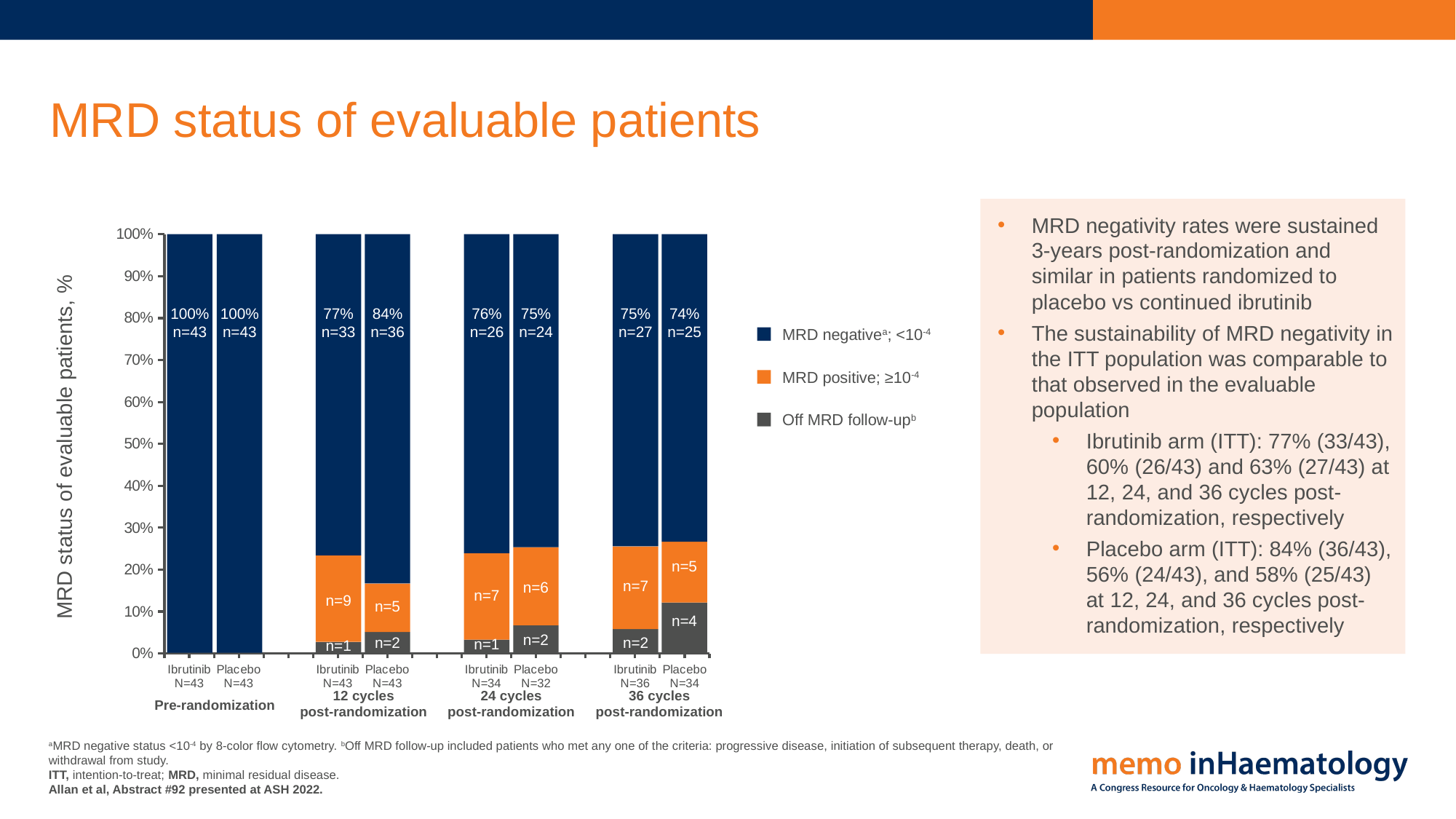
How many bars are plotted in the chart? 8 Which bar has the lowest MRD negative percentage? Placebo at 36 cycles post-randomization (74%) Does the MRD negative percentage for the Ibrutinib arm rise or fall from pre-randomization to 36 cycles post-randomization? Fall At 12 cycles post-randomization, what is the difference in MRD negative percentage between the Placebo and Ibrutinib arms? 7 percentage points How many patients were off MRD follow-up in the Placebo arm at 36 cycles post-randomization? n=4 How many series does the legend list? 3 What is the total number of patients across the three segments of the Ibrutinib bar at 36 cycles post-randomization (n=27, n=7, n=2)? 36 At 12 cycles post-randomization, which arm has the higher MRD negative percentage, Ibrutinib or Placebo? Placebo What kind of chart is shown on the slide? Stacked bar chart What is the N for the Placebo arm at 24 cycles post-randomization? N=32 What MRD negative percentage is shown for the Placebo arm at 12 cycles post-randomization? 84% How many patients were MRD positive in the Ibrutinib arm at 12 cycles post-randomization? n=9